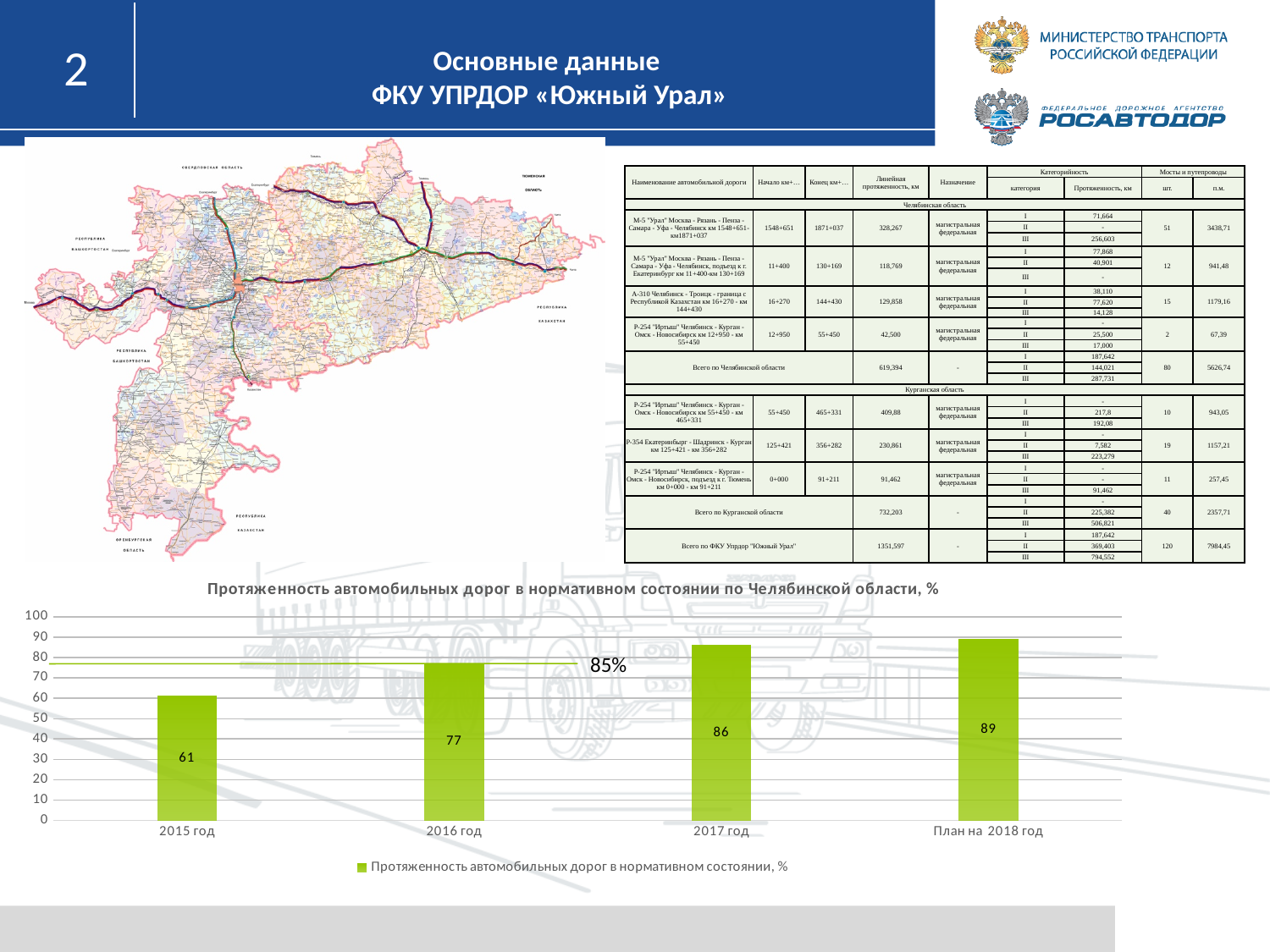
What kind of chart is shown on the slide? bar chart How many series does the chart legend list? 1 What is the value for 2015 год in the chart? 61 Which is larger, the value for 2016 год or the value for 2017 год? 2017 год What is the value for План на 2018 год in the chart? 89 How many categories are shown on the x axis of the chart? 4 Which category has the lowest value in the chart? 2015 год What is the difference between the values for 2016 год and 2015 год? 16 What is the difference between the values for План на 2018 год and 2017 год? 3 Which category has the highest value in the chart? План на 2018 год Do the values rise or fall from 2015 год to План на 2018 год? rise What is the value for 2017 год in the chart? 86